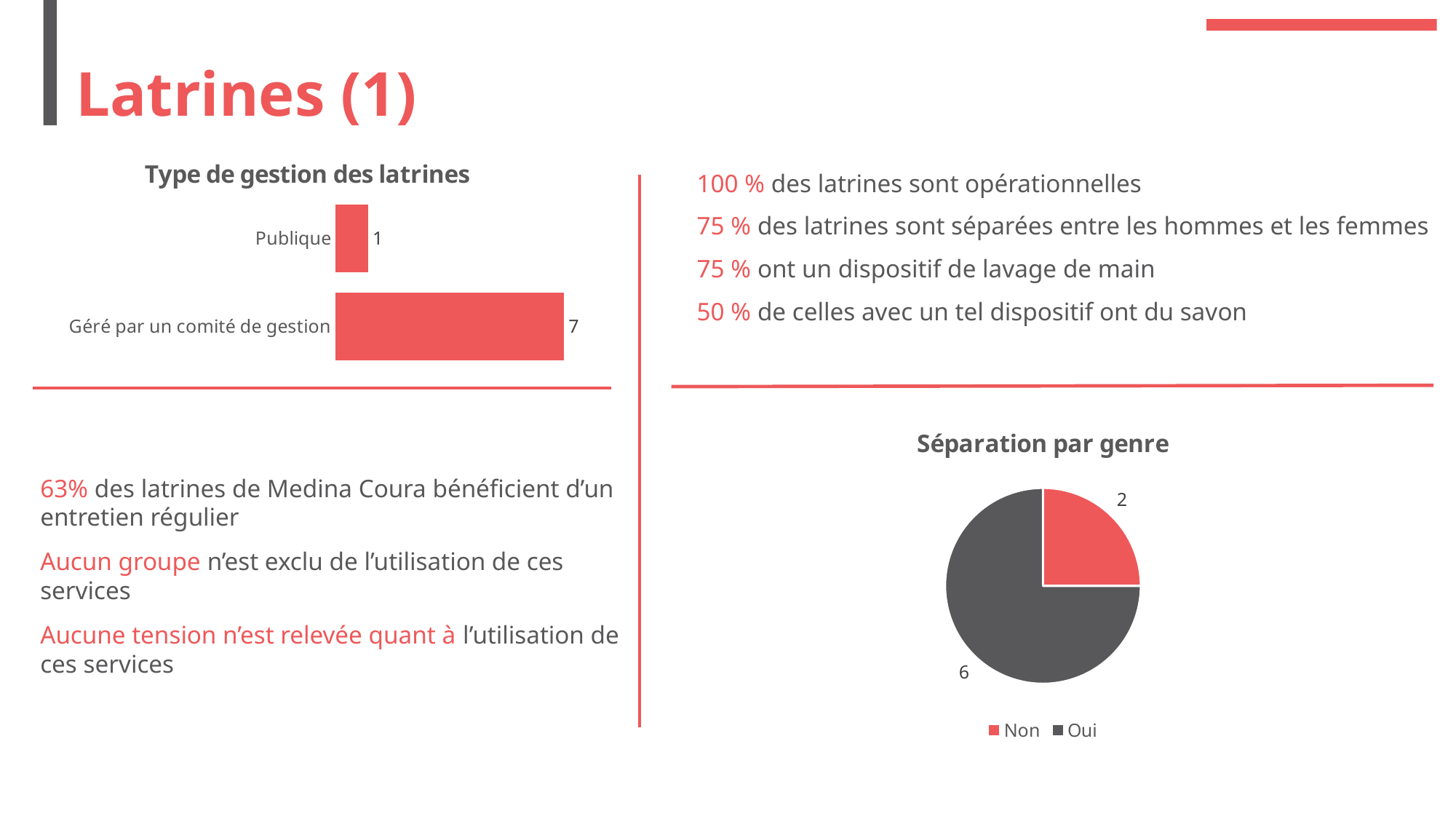
In the 'Séparation par genre' chart, how many entries does the legend list? 2 In the 'Type de gestion des latrines' chart, what is the difference between 'Géré par un comité de gestion' and 'Publique'? 6 In the 'Séparation par genre' chart, what share of the total does 'Non' represent? 25% In the 'Type de gestion des latrines' chart, what is the value for 'Géré par un comité de gestion'? 7 In the 'Type de gestion des latrines' chart, what is the value for 'Publique'? 1 In the 'Type de gestion des latrines' chart, how many categories are shown? 2 In the 'Séparation par genre' chart, which slice is larger, 'Oui' or 'Non'? Oui In the 'Séparation par genre' chart, what is the value for 'Non'? 2 In the 'Séparation par genre' chart, what is the value for 'Oui'? 6 In the 'Type de gestion des latrines' chart, which category has the highest value? Géré par un comité de gestion What kind of chart is 'Séparation par genre'? Pie chart What kind of chart is 'Type de gestion des latrines'? Bar chart